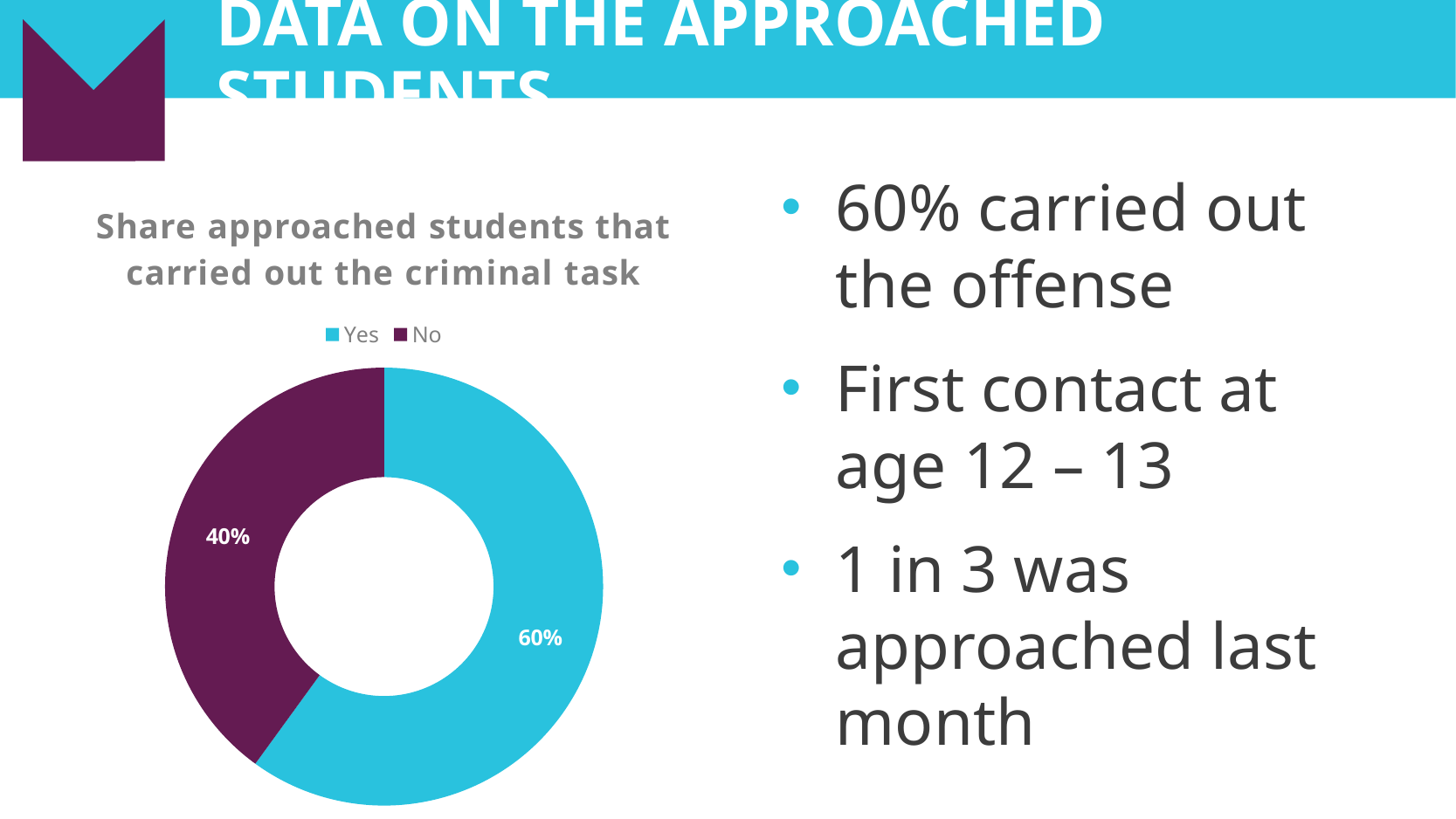
Which category has the largest share in the chart? Yes What is the title of the chart? Share approached students that carried out the criminal task Which category has the larger share, Yes or No? Yes What is the difference in percentage points between the Yes and No shares? 20 percentage points What share of approached students carried out the criminal task (Yes)? 60% Which category has the smallest share in the chart? No Which colour represents the No category in the chart? Purple What share of approached students did not carry out the criminal task (No)? 40% What kind of chart is shown on the slide? Pie (doughnut) chart Is the share for Yes greater or less than 50%? greater How many entries does the legend list? 2 How many categories does the chart show? 2